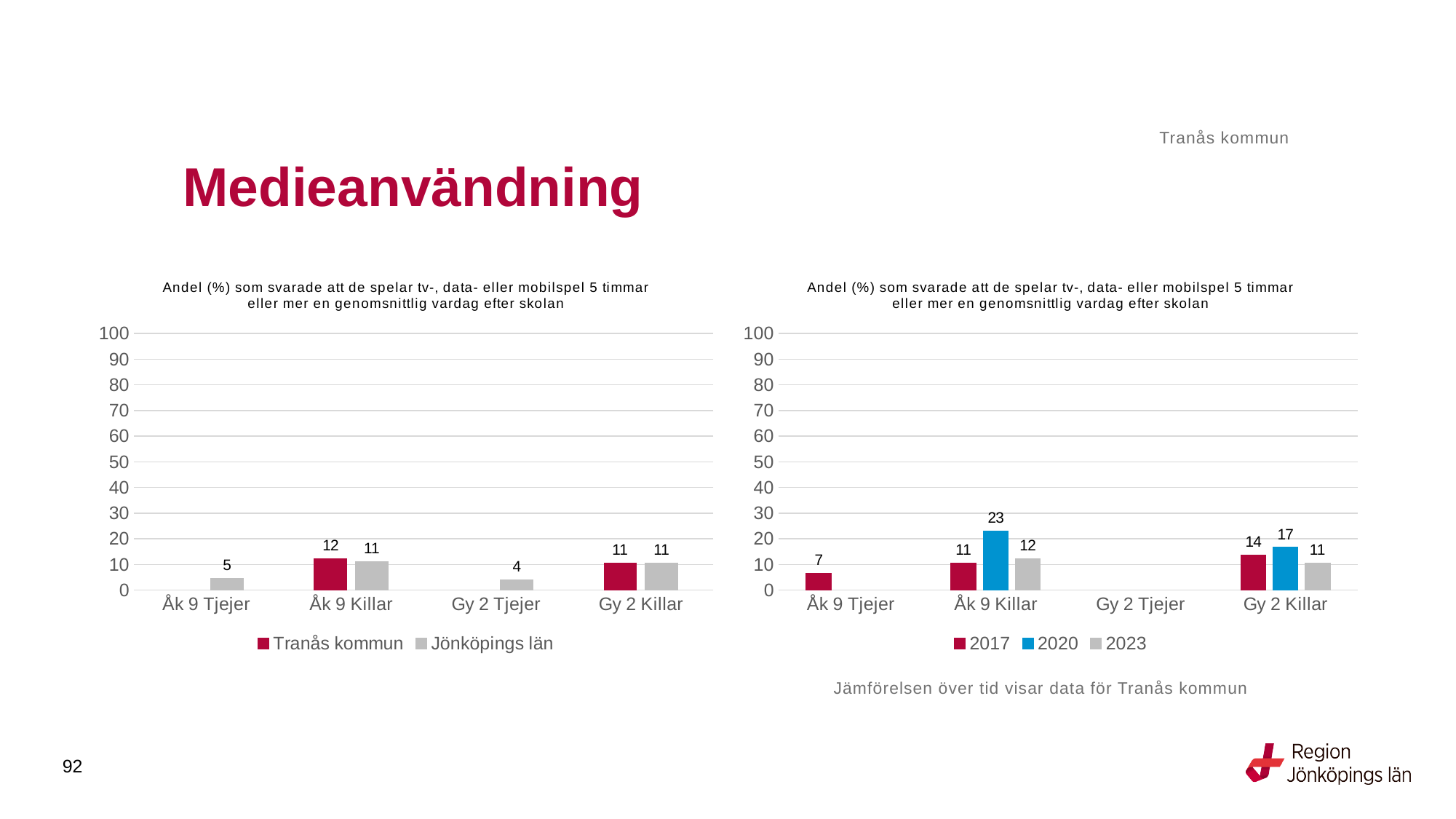
In the right chart, what is the value for 2017 for Gy 2 Killar? 14 In the right chart, how many series does the legend list? 3 In the left chart, which category has the lowest value for Jönköpings län? Gy 2 Tjejer In the left chart, what is the value for Jönköpings län for Åk 9 Killar? 11 In the right chart, what is the value for 2020 for Åk 9 Killar? 23 In the right chart, is the 2017 value for Åk 9 Killar or the 2017 value for Gy 2 Killar larger? Gy 2 Killar In the left chart, what is the value for Jönköpings län for Gy 2 Tjejer? 4 In the right chart, what is the difference between the 2020 and 2023 values for Åk 9 Killar? 11 In the right chart, which year has the highest value for Gy 2 Killar? 2020 In the left chart, what is the value for Tranås kommun for Åk 9 Killar? 12 In the left chart, how many series does the legend list? 2 What kind of chart is the left chart? Bar chart